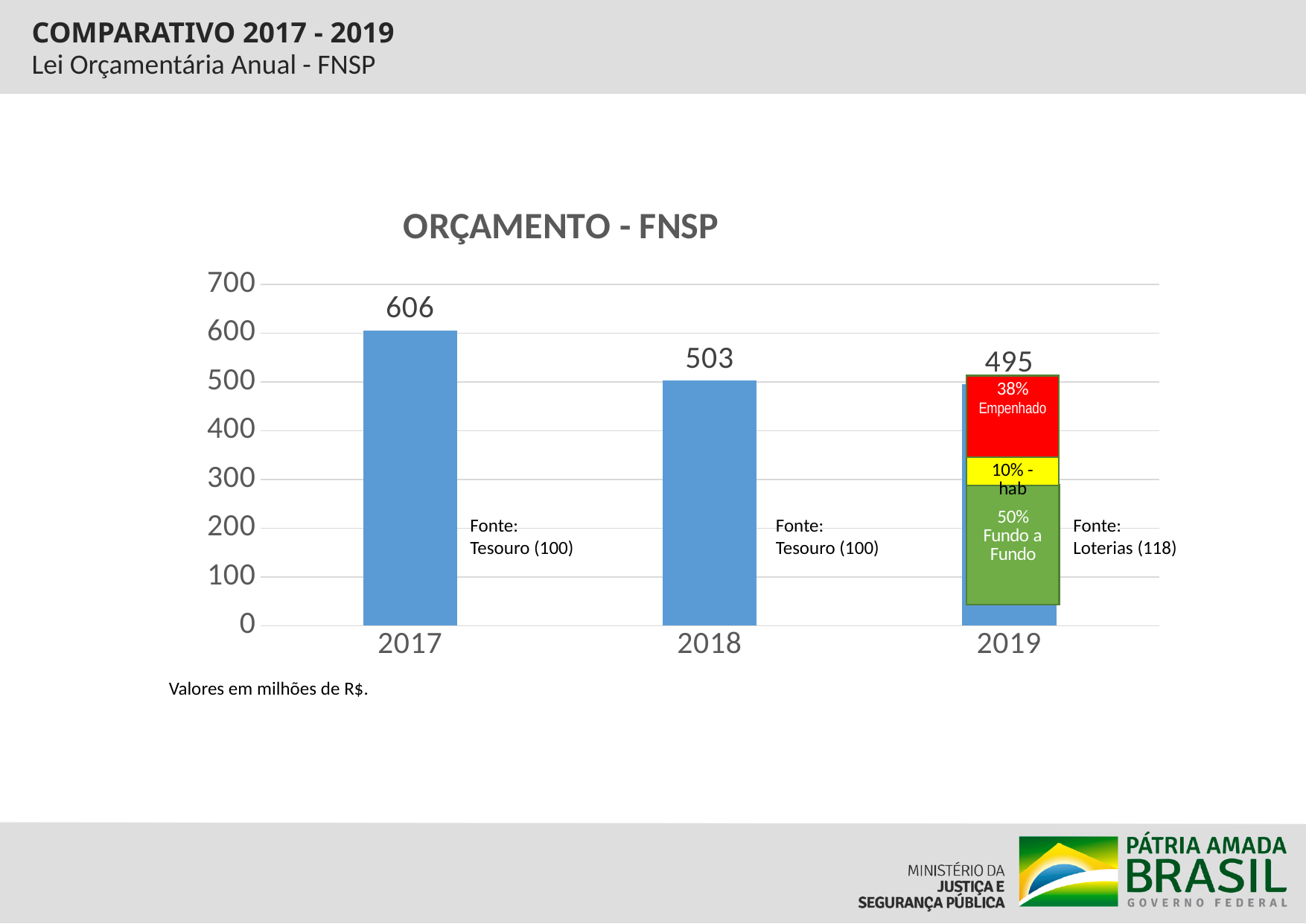
What is the difference between the values for 2017 and 2018? 103 What kind of chart is shown on the slide? bar chart What is the value for 2018 in the ORÇAMENTO - FNSP chart? 503 Which year has the lowest value in the ORÇAMENTO - FNSP chart? 2019 What is the value for 2017 in the ORÇAMENTO - FNSP chart? 606 Which is larger, the value for 2017 or the value for 2018? 2017 Which year has the highest value in the ORÇAMENTO - FNSP chart? 2017 Is the value for 2019 greater or less than 500? less What is the difference between the values for 2017 and 2019? 111 What is the value for 2019 in the ORÇAMENTO - FNSP chart? 495 How many years are shown on the x axis of the chart? 3 Do the values rise or fall from 2017 to 2019? fall